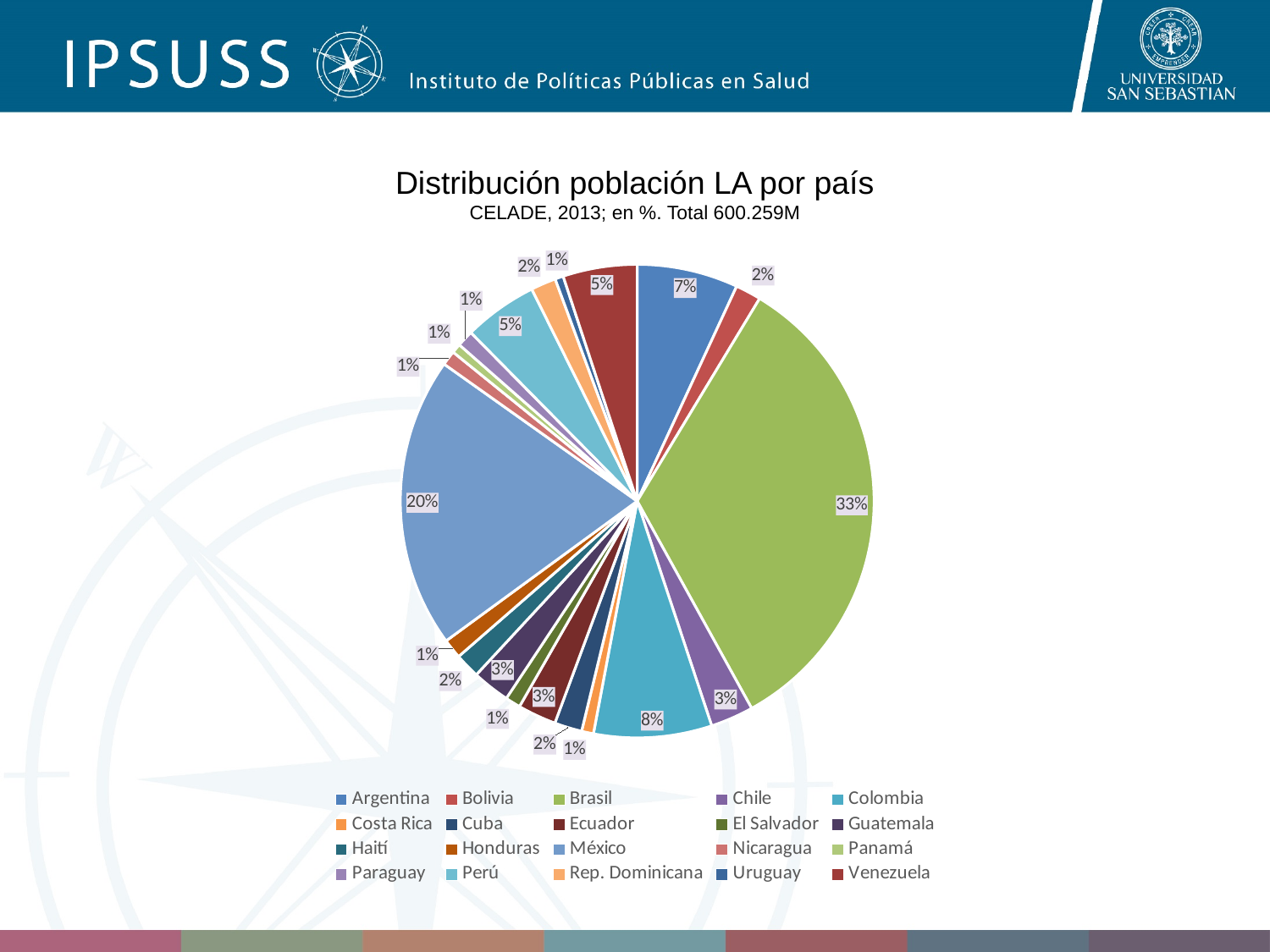
What percentage is shown for Argentina? 7% What share of the pie does México represent? 20% What percentage is shown for Colombia? 8% How many countries are listed in the legend? 20 What percentage is shown for Venezuela? 5% What share of the pie does Brasil represent? 33% What kind of chart is shown on the slide? Pie chart What is the title of the chart? Distribución población LA por país Which country has the largest slice of the pie? Brasil Which is larger, the slice for Brasil or the slice for México? Brasil What is the difference in percentage points between Brasil and México? 13 percentage points Which is larger, the slice for Colombia or the slice for Argentina? Colombia